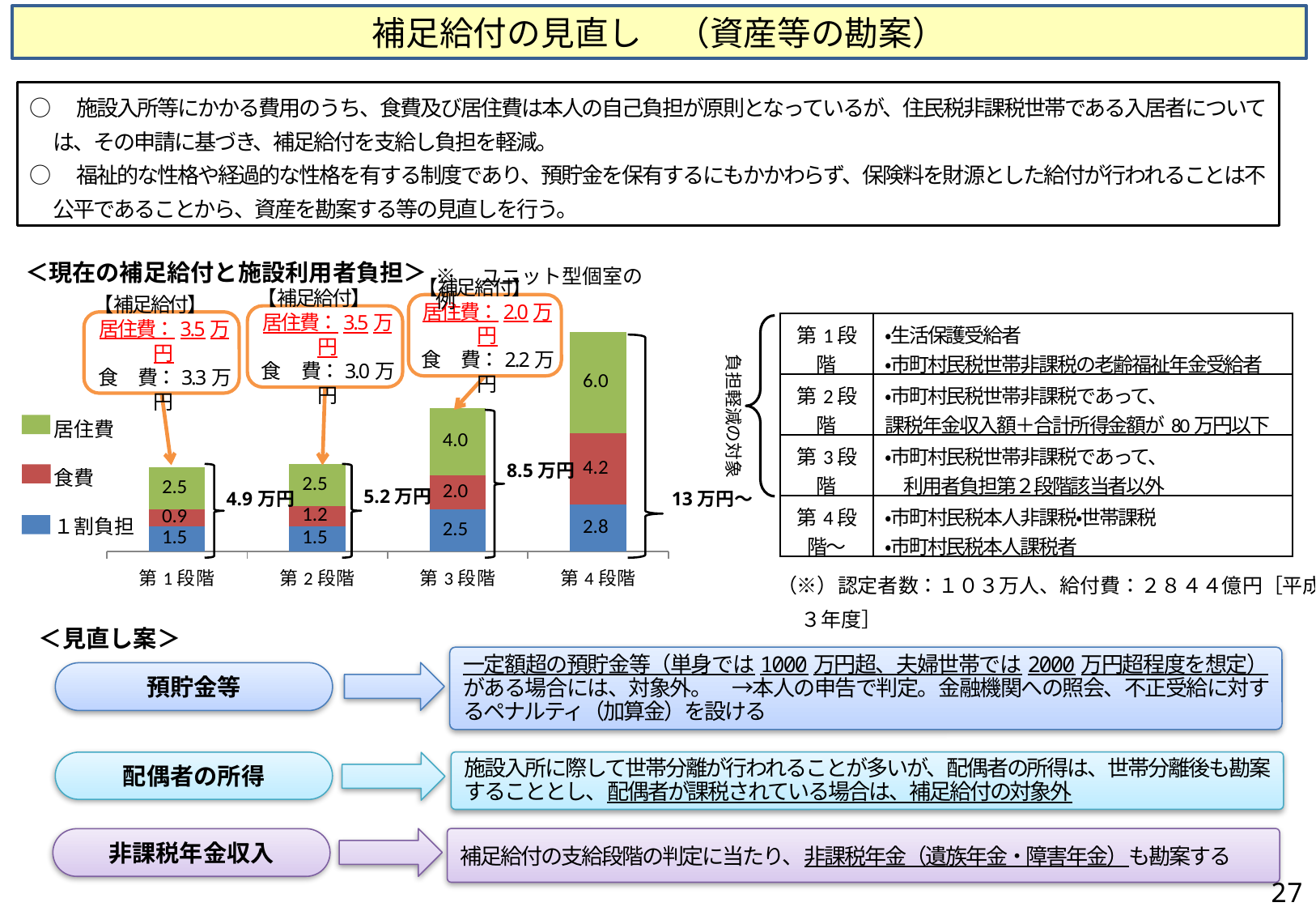
What is the difference between the 食費 values for 第４段階 and 第３段階? 2.2 Which 段階 has the highest 居住費 value? 第４段階 What type of chart is shown under ＜現在の補足給付と施設利用者負担＞? stacked bar chart What is the 食費 value for 第２段階? 1.2 What is the total labelled for the 第３段階 stacked bar? 8.5万円 How many categories (段階) are shown on the x axis of the chart? 4 Which 段階 has the lowest 食費 value? 第１段階 How many series does the chart's legend list? 3 Which series is shown in green in the chart? 居住費 What is the 居住費 value for 第３段階? 4.0 Which is larger, the １割負担 value for 第３段階 or for 第２段階? 第３段階 What is the １割負担 value for 第４段階? 2.8